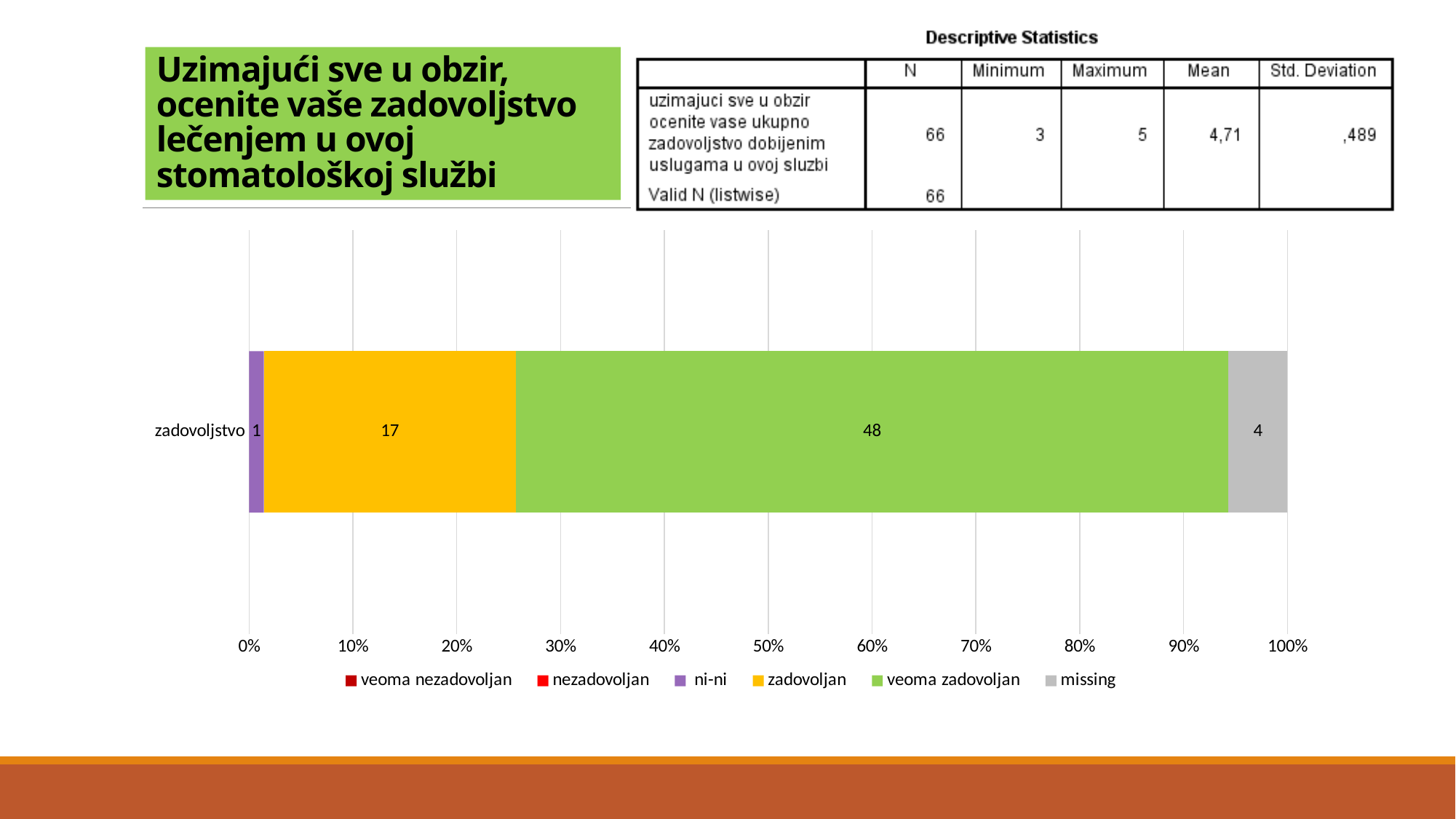
What is the value for the 'veoma zadovoljan' segment of the 'zadovoljstvo' bar? 48 How many series does the legend list? 6 What is the value for the 'missing' segment of the 'zadovoljstvo' bar? 4 What is the value for the 'zadovoljan' segment of the 'zadovoljstvo' bar? 17 What kind of chart is shown on the slide? stacked bar chart What is the total of the printed values in the 'zadovoljstvo' bar? 70 What is the difference between the 'veoma zadovoljan' and 'zadovoljan' values? 31 Which is larger, the 'zadovoljan' value or the 'missing' value? zadovoljan Which labelled series has the smallest segment in the 'zadovoljstvo' bar? ni-ni What is the value for the 'ni-ni' segment of the 'zadovoljstvo' bar? 1 What colour is the 'veoma zadovoljan' series in the chart? green Which series has the largest segment in the 'zadovoljstvo' bar? veoma zadovoljan